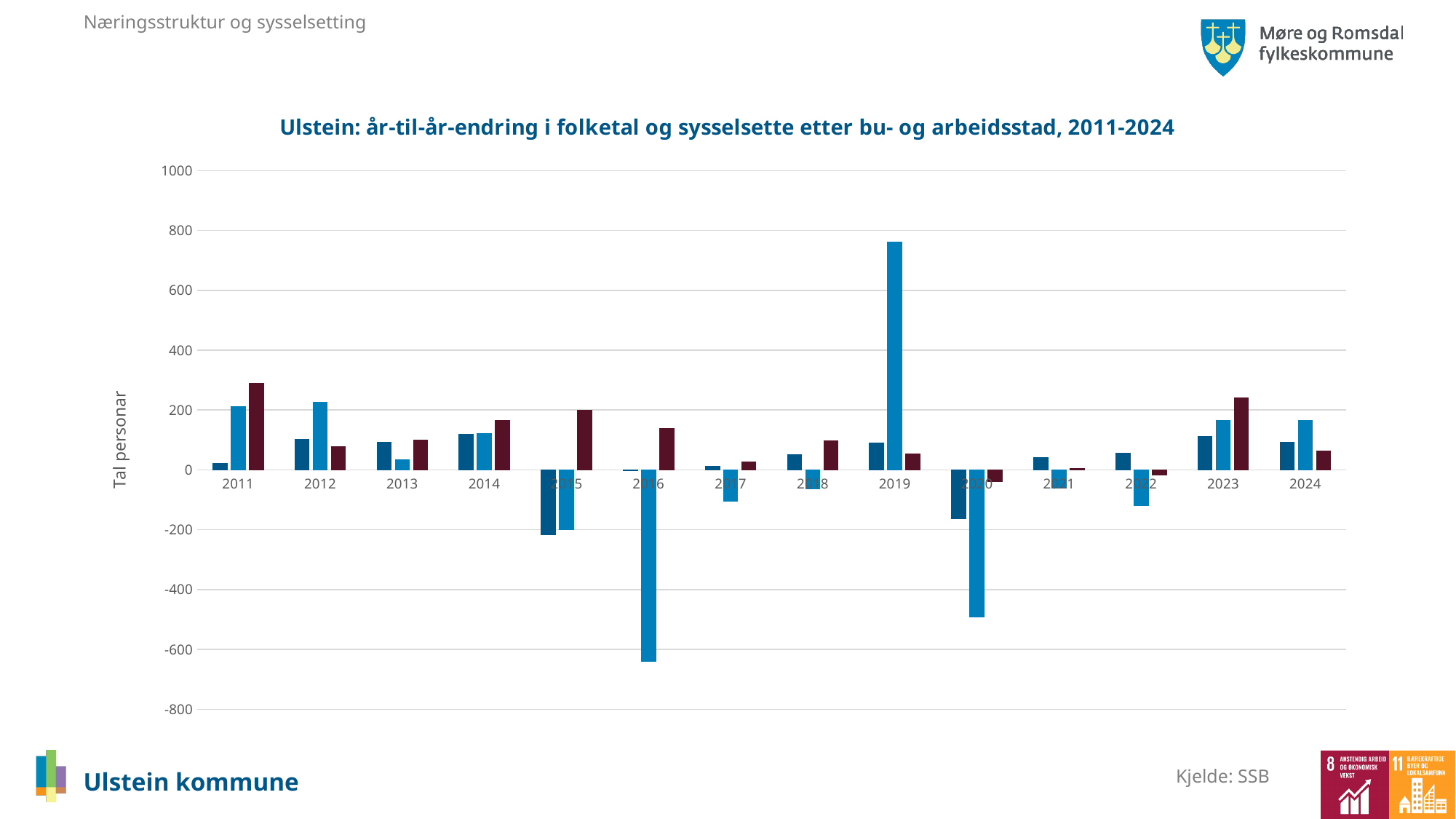
What is the title of the chart? Ulstein: år-til-år-endring i folketal og sysselsette etter bu- og arbeidsstad, 2011-2024 How many years are shown on the x axis of the chart? 14 What kind of chart is shown on the slide? bar chart In 2011, which is taller: the dark red bar or the light blue bar? the dark red bar What is the label on the vertical axis of the chart? Tal personar In which year is the light blue bar the lowest? 2016 In which year is the light blue bar the highest? 2019 Is the value of the light blue bar for 2020 greater or less than -400? less Is the value of the light blue bar for 2019 greater or less than 600? greater Is the value of the dark red bar for 2011 greater or less than 200? greater